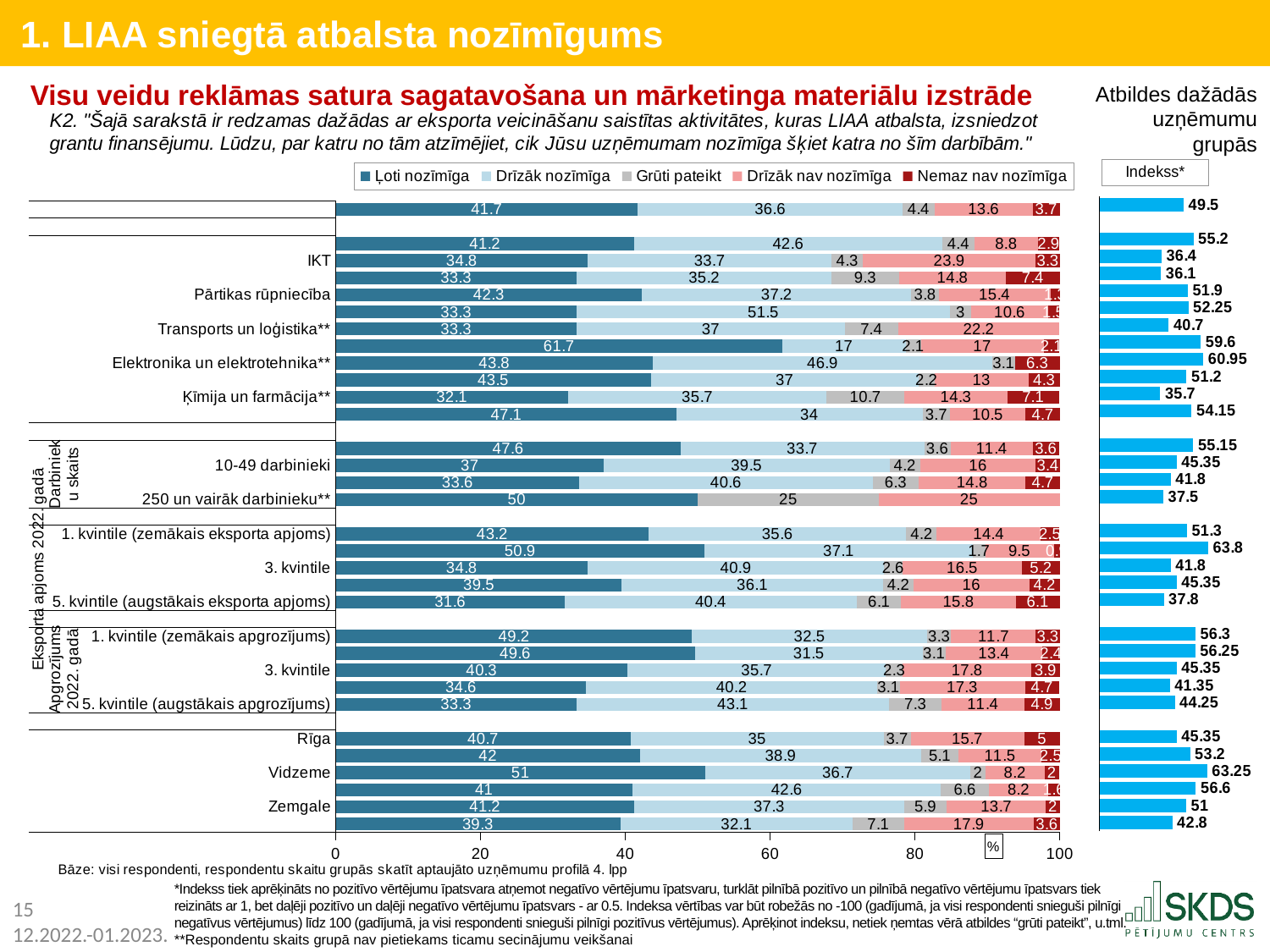
In the Indekss* chart, what is the index value for Vidzeme? 63.25 In the Indekss* chart, what is the index value for Ķīmija un farmācija**? 35.7 In the Indekss* chart, which of Rīga, Vidzeme and Zemgale has the highest index value? Vidzeme In the main chart, what is the difference between the 'Ļoti nozīmīga' values for Rīga (40.7) and Zemgale (41.2)? 0.5 In the main chart, what is the 'Grūti pateikt' value for 250 un vairāk darbinieku**? 25 In the main chart, what is the 'Ļoti nozīmīga' value for Vidzeme? 51 What kind of chart is the main chart on the slide? Stacked bar chart In the main chart, what is the 'Ļoti nozīmīga' value for IKT? 34.8 How many series does the legend of the main chart list? 5 In the main chart, which has a larger 'Ļoti nozīmīga' value: Pārtikas rūpniecība or Ķīmija un farmācija**? Pārtikas rūpniecība In the main chart, what is the 'Drīzāk nozīmīga' value for Elektronika un elektrotehnika**? 46.9 In the main chart, what is the 'Drīzāk nav nozīmīga' value for IKT? 23.9